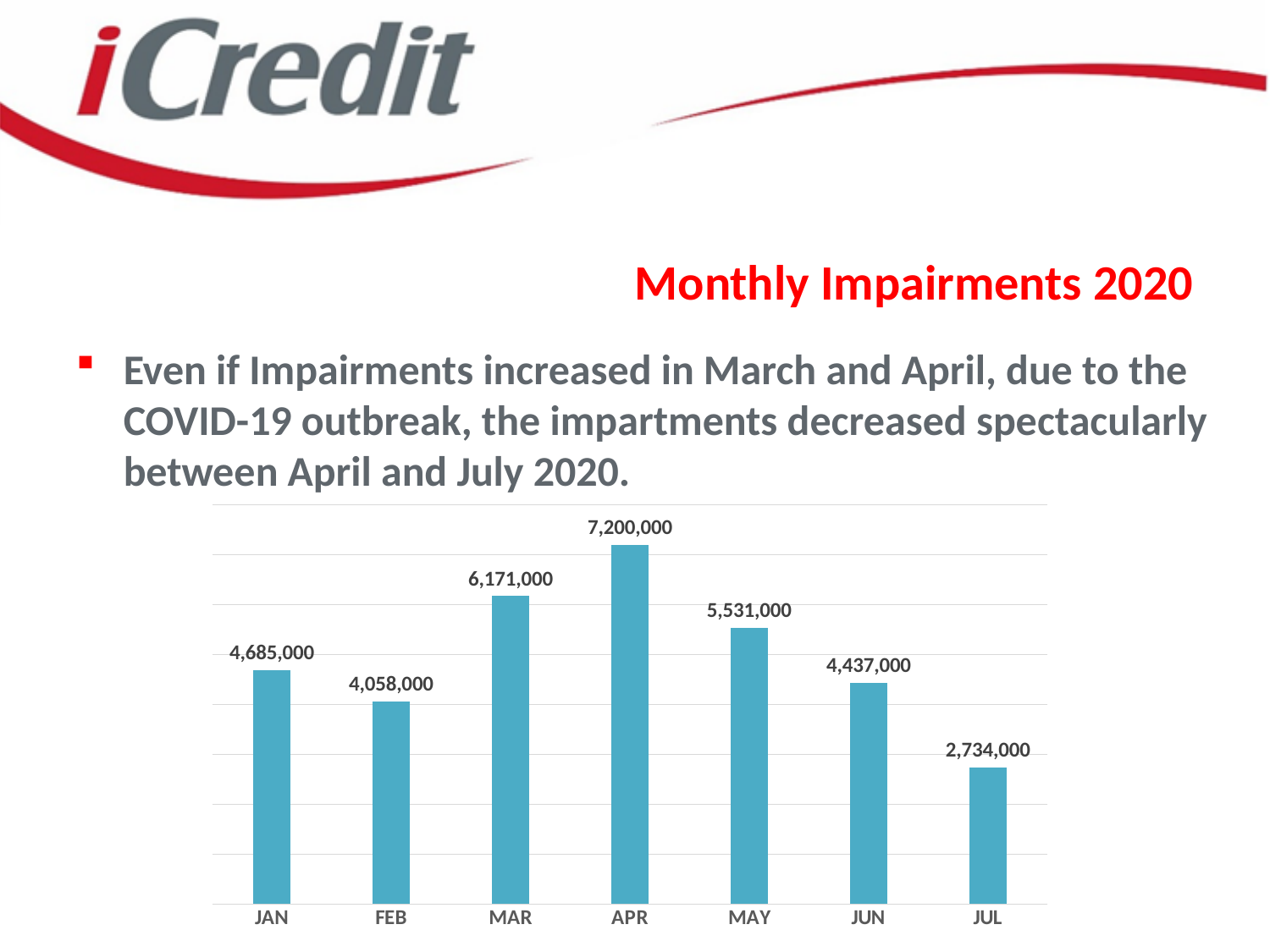
What kind of chart is shown on the slide? Bar chart What is the difference between the impairment values for MAR and FEB? 2,113,000 What is the impairment value for JUL? 2,734,000 Which month has the lowest impairment value? JUL What is the impairment value for JAN? 4,685,000 Do the impairment values rise or fall from APR to JUL? Fall Which month has the highest impairment value? APR Which is larger, the impairment value for MAY or for JUN? MAY What is the difference between the impairment values for APR and JUL? 4,466,000 What is the impairment value for APR? 7,200,000 What colour are the bars in the chart? Blue How many months are shown on the chart? 7